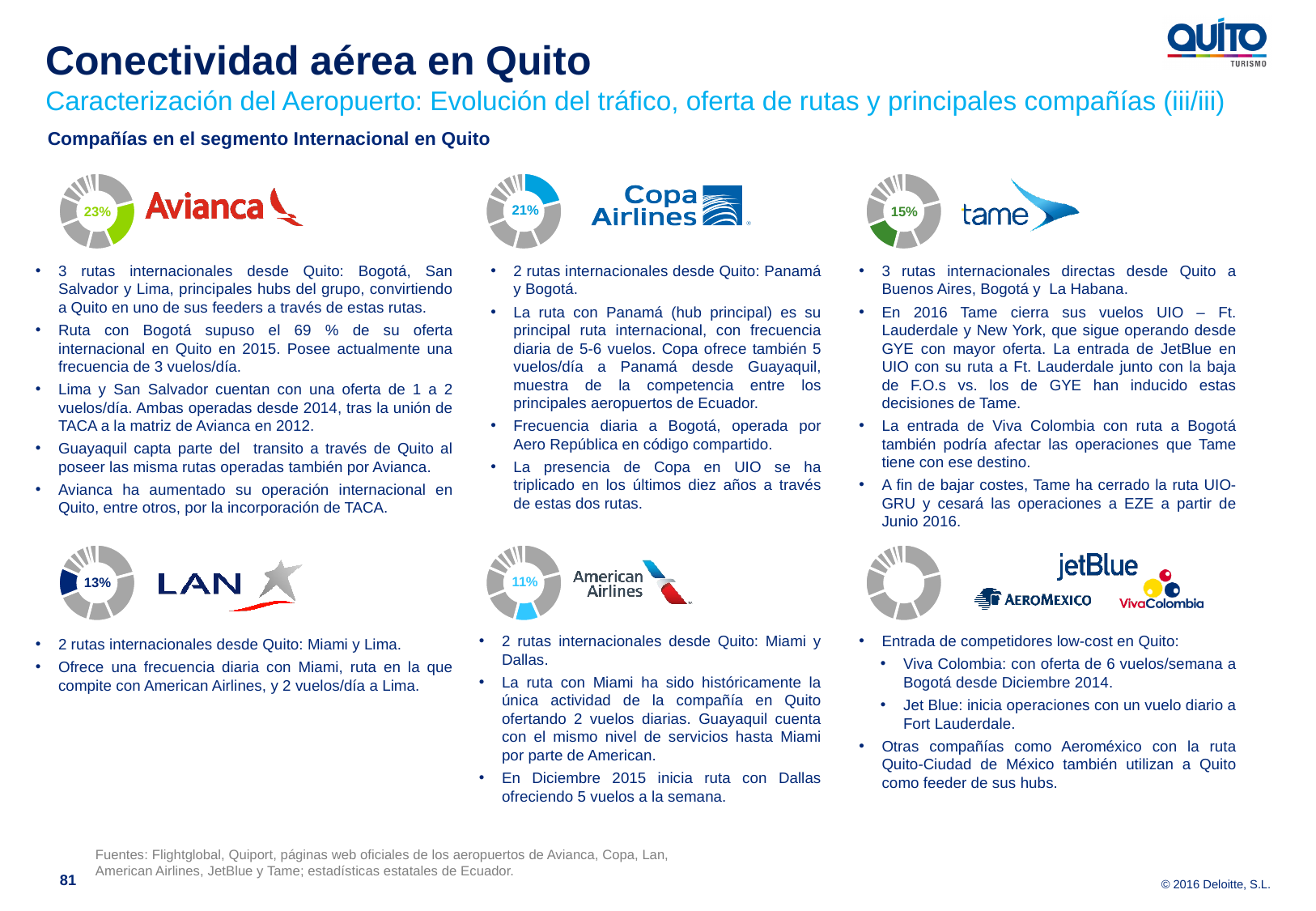
What kind of chart is used next to each airline logo on the slide? Donut (pie) chart Among the donut charts with a printed percentage, which airline has the lowest value? American Airlines What percentage is shown in the donut chart next to the Avianca logo? 23% What percentage is shown in the donut chart next to the American Airlines logo? 11% What percentage is shown in the donut chart next to the LAN logo? 13% What is the difference between the percentage shown for Avianca and the percentage shown for Copa Airlines? 2% What percentage is shown in the donut chart next to the Tame logo? 15% How many donut charts on the slide have a percentage printed inside them? 5 What percentage is shown in the donut chart next to the Copa Airlines logo? 21% Which airline's donut chart shows the highest percentage on the slide? Avianca What is the difference between the percentage shown for Tame and the percentage shown for American Airlines? 4% Which is larger, the percentage shown for Tame or the percentage shown for LAN? Tame